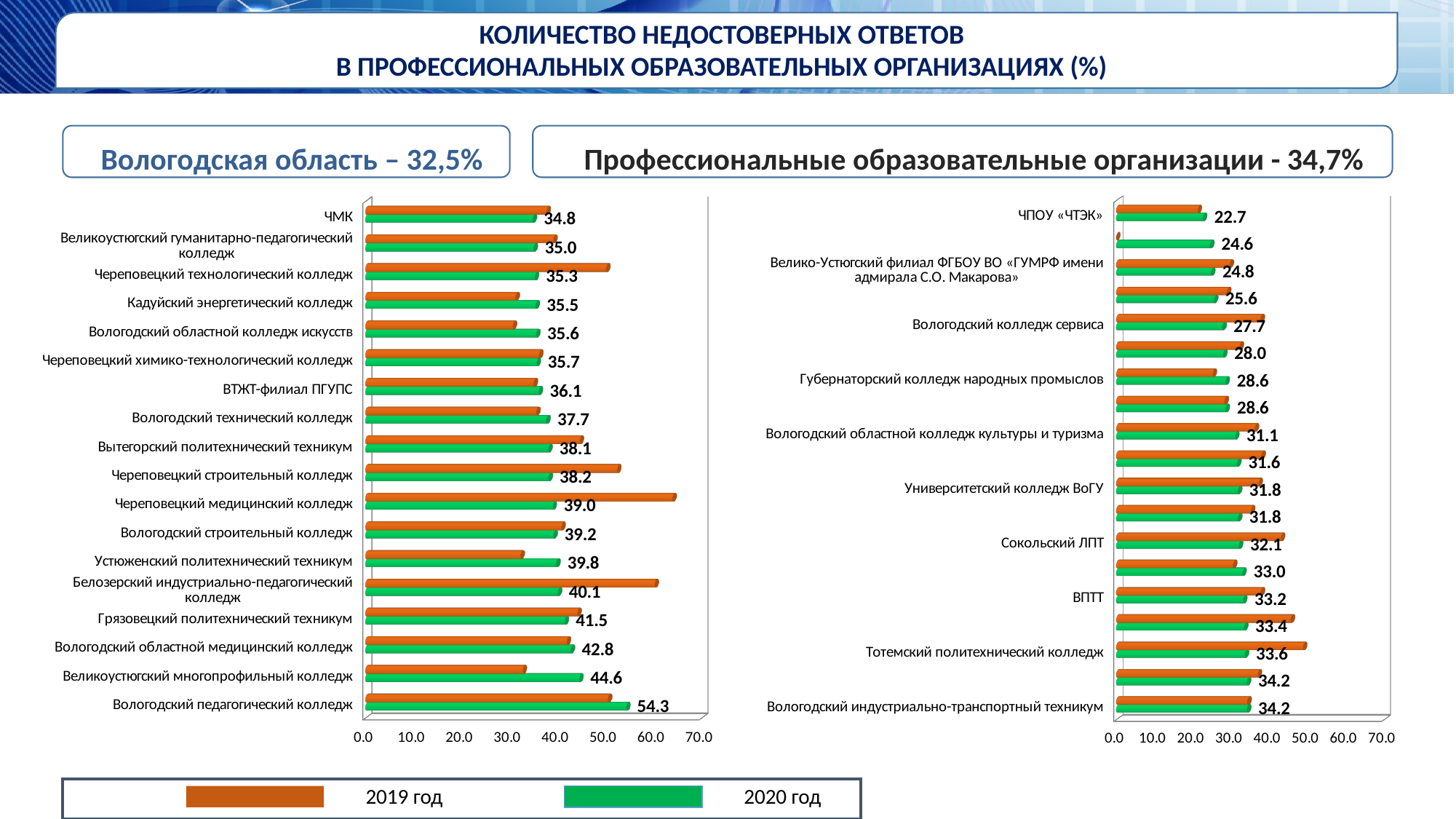
In the left chart (Вологодская область), which organisation has the highest 2020 value? Вологодский педагогический колледж What type of chart is used on the left side of the slide (Вологодская область)? Bar chart In the left chart (Вологодская область), is the 2019 value for Череповецкий медицинский колледж greater or less than 60.0? greater In the left chart (Вологодская область), how many organisations are listed? 18 How many series does the legend list? 2 In the left chart (Вологодская область), what is the 2020 value for ЧМК? 34.8 In the right chart (Профессиональные образовательные организации), what is the 2020 value for ЧПОУ «ЧТЭК»? 22.7 In the right chart (Профессиональные образовательные организации), which has the larger 2020 value: Вологодский колледж сервиса or ВПТТ? ВПТТ In the left chart (Вологодская область), what is the difference between the 2020 values for Вологодский педагогический колледж and Великоустюгский многопрофильный колледж? 9.7 In the right chart (Профессиональные образовательные организации), what is the 2020 value for Сокольский ЛПТ? 32.1 In the left chart (Вологодская область), which organisation has the lowest 2020 value? ЧМК In the left chart (Вологодская область), what is the 2020 value for Вологодский педагогический колледж? 54.3